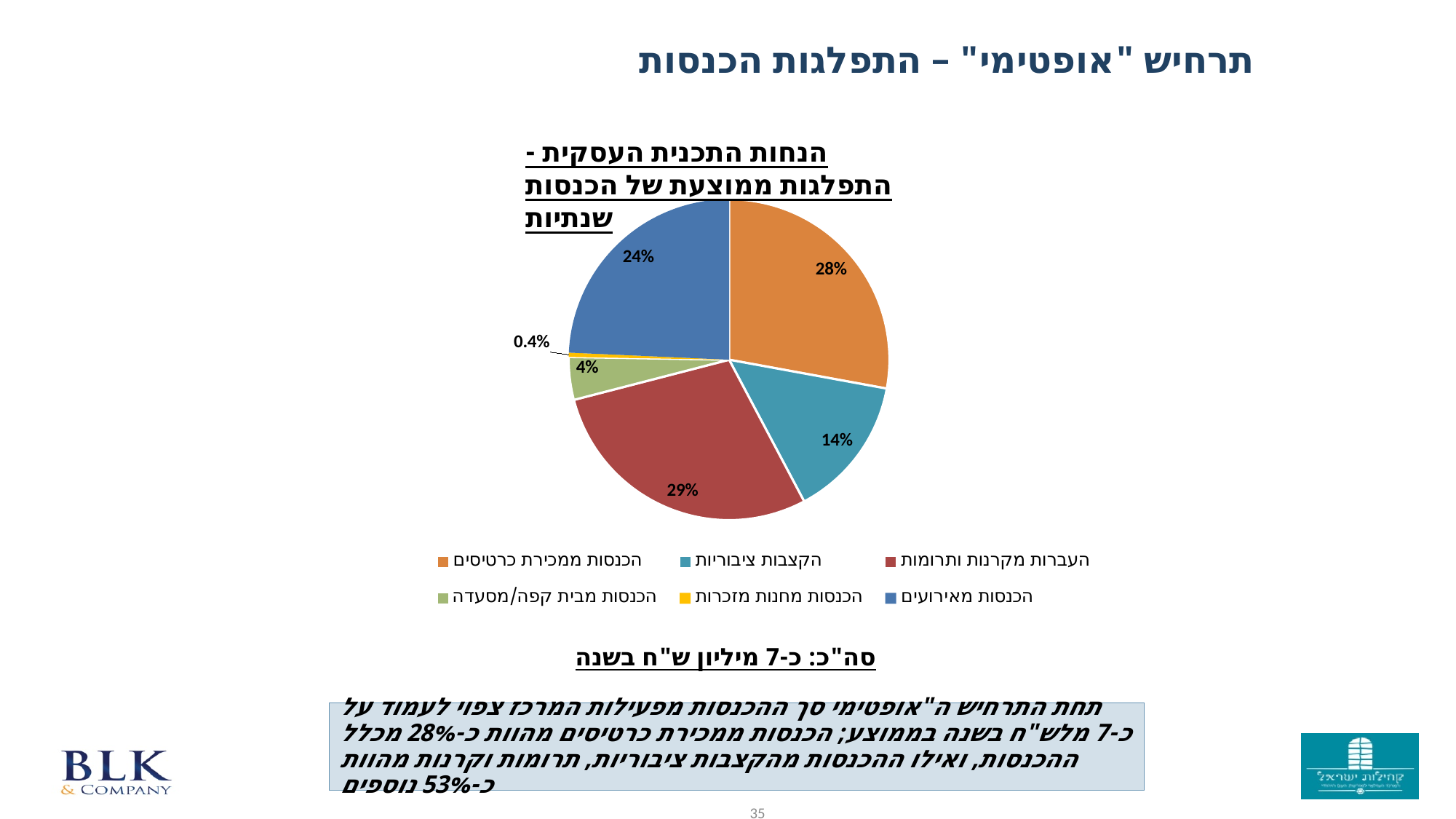
What share of annual income comes from הכנסות מחנות מזכרות (gift shop income)? 0.4% Which colour represents הכנסות מאירועים in the pie chart? Blue What share of annual income comes from הקצבות ציבוריות (public allocations)? 14% What type of chart is shown on the slide? Pie chart How many slices does the pie chart have? 6 Which income source has the smallest share of the pie? הכנסות מחנות מזכרות Which income source has the largest share of the pie? העברות מקרנות ותרומות What is the difference in percentage points between הכנסות ממכירת כרטיסים and הכנסות מאירועים? 4 percentage points What share of annual income comes from הכנסות מאירועים (event income)? 24% What share of annual income comes from הכנסות ממכירת כרטיסים (ticket sales)? 28% What share of annual income comes from הכנסות מבית קפה/מסעדה (café/restaurant income)? 4% What share of annual income comes from העברות מקרנות ותרומות (transfers from funds and donations)? 29%